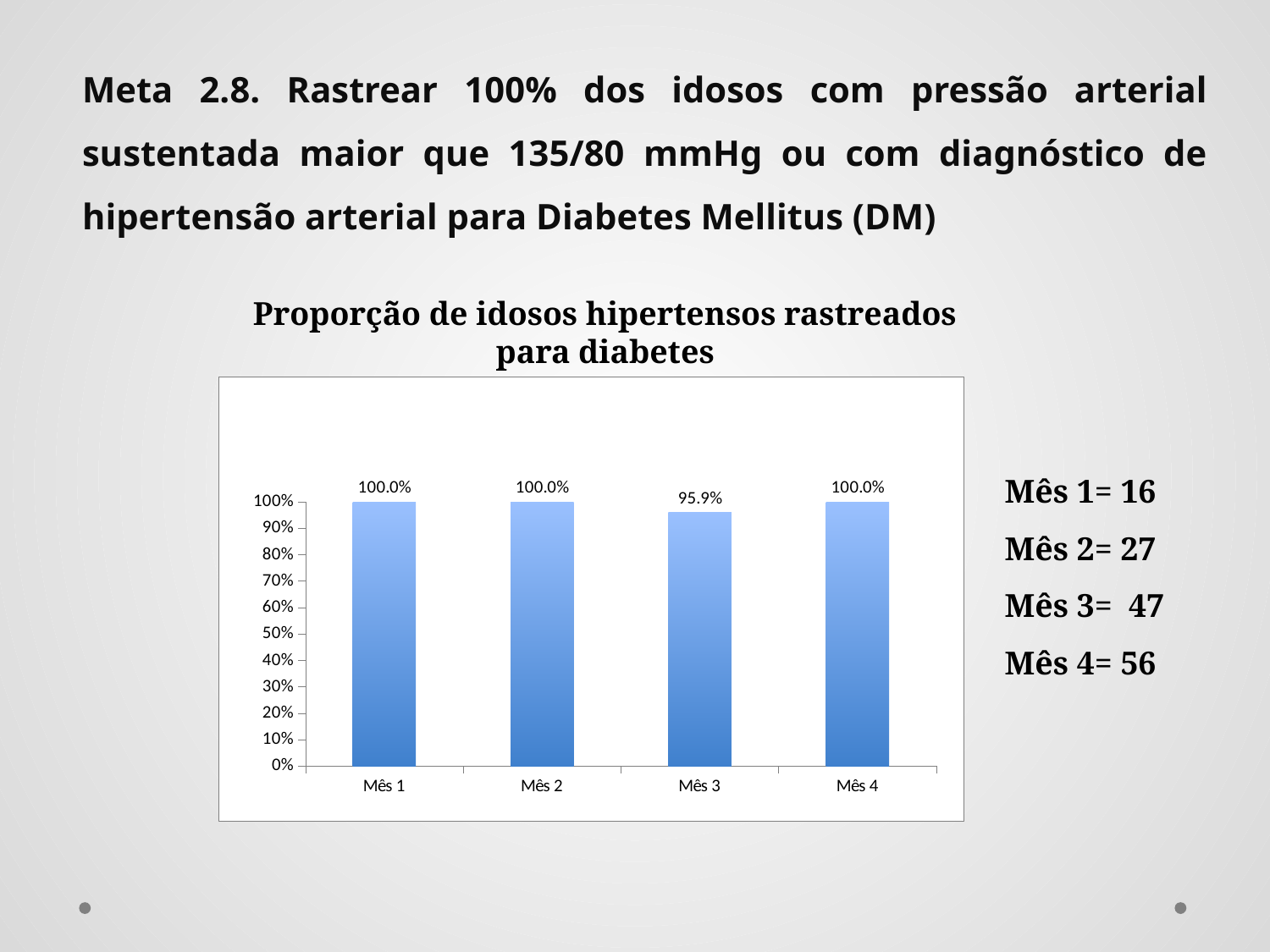
What kind of chart is shown on the slide? bar chart Which is larger, the value for Mês 3 or the value for Mês 4? Mês 4 What is the difference between the values for Mês 2 and Mês 3? 4.1% What is the title of the chart? Proporção de idosos hipertensos rastreados para diabetes What is the value for Mês 4? 100.0% What is the value for Mês 3? 95.9% Is the value for Mês 3 greater or less than 90%? greater What is the highest value shown on the y axis? 100% How many months have a value of 100.0%? 3 Which month has the lowest value? Mês 3 What is the value for Mês 1? 100.0% How many months are shown on the x axis? 4